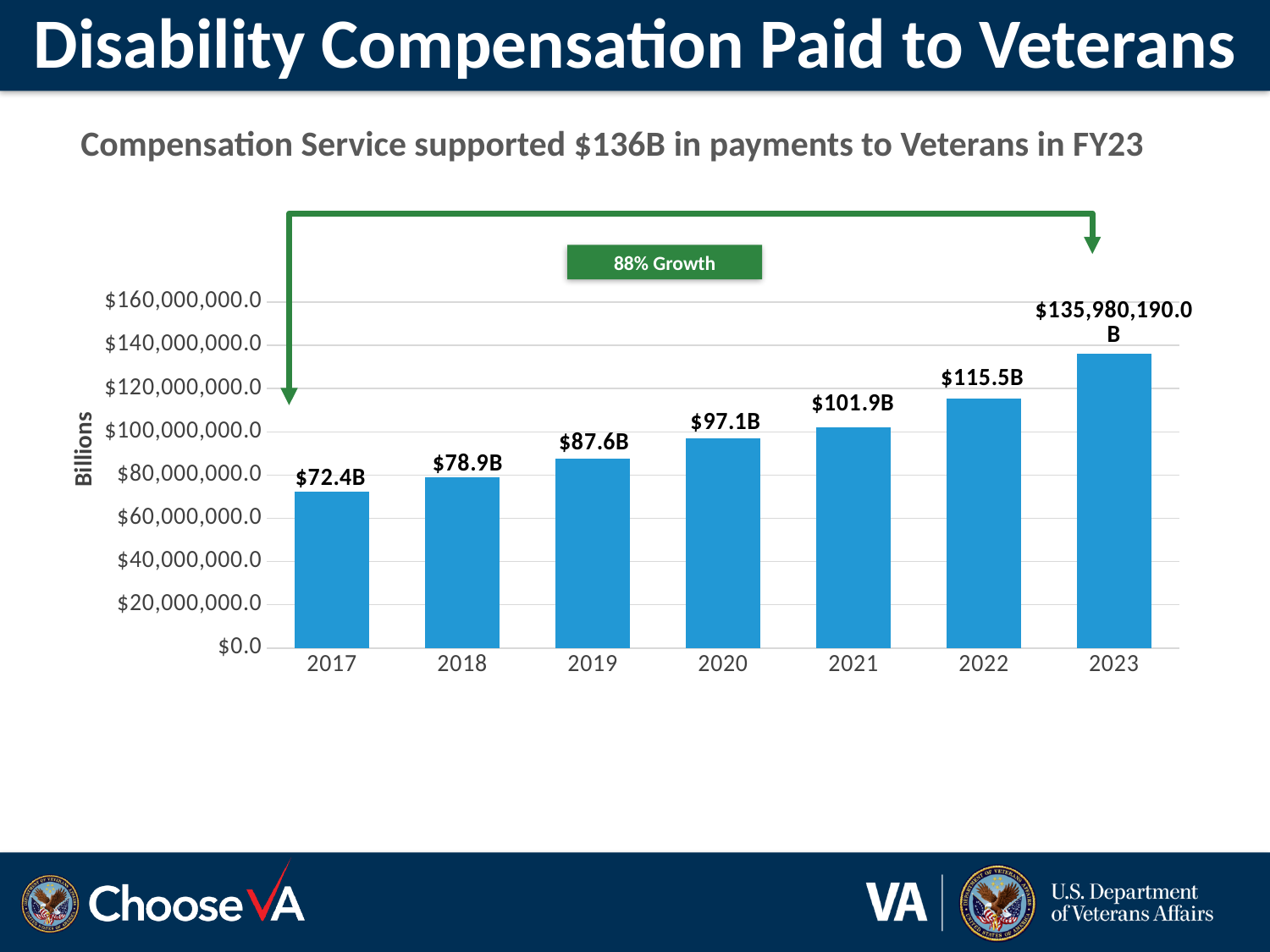
What growth percentage is shown in the green annotation box above the chart? 88% Growth What is the value shown for 2017? $72.4B What is the value shown for 2020? $97.1B How many years are shown on the x axis? 7 Which year has the lowest value? 2017 What is the difference between the values for 2022 and 2021? $13.6B What is the value shown for 2022? $115.5B What type of chart is shown on the slide? bar chart Which is larger, the value for 2019 or the value for 2021? 2021 Do the values rise or fall from 2017 to 2023? rise What is the difference between the values for 2018 and 2017? $6.4B Which year has the highest value? 2023